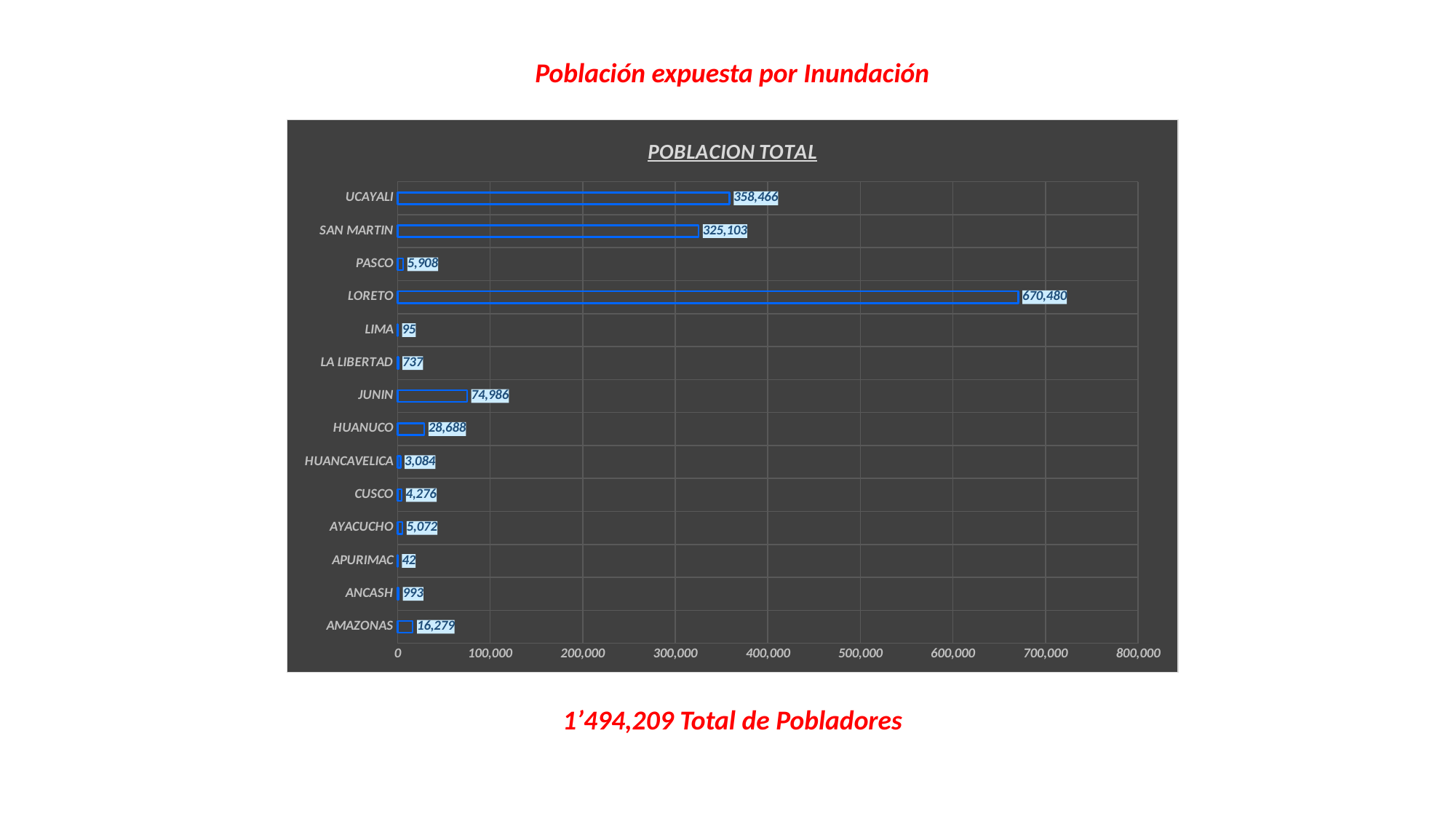
What is the value for SAN MARTIN? 325,103 Which category has the lowest value? APURIMAC How many categories are shown in the chart? 14 What is the value for HUANUCO? 28,688 What is the value for AMAZONAS? 16,279 Is the value for LORETO greater or less than 600,000? greater What is the difference between the values for JUNIN and HUANUCO? 46,298 What kind of chart is shown on the slide? bar chart Which is larger, the value for UCAYALI or the value for SAN MARTIN? UCAYALI Which category has the highest value? LORETO What is the difference between the values for LORETO and UCAYALI? 312,014 What is the value for LORETO? 670,480